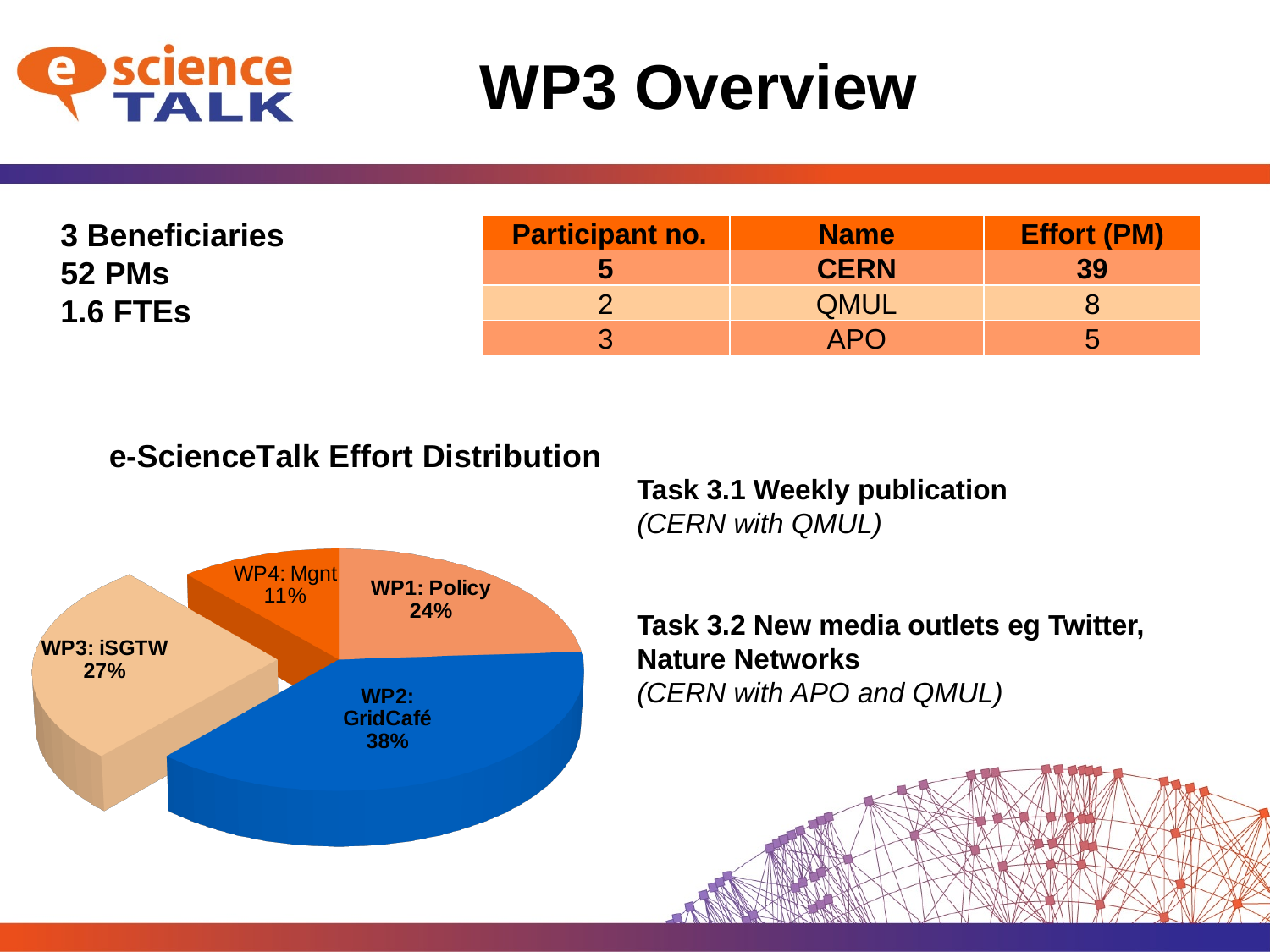
What kind of chart is shown on the slide? Pie chart What is the difference in percentage points between WP2: GridCafé and WP4: Mgnt? 27 What is the title of the chart? e-ScienceTalk Effort Distribution What share of the pie does WP4: Mgnt have? 11% What share of the pie does WP1: Policy have? 24% Which is larger, the share for WP1: Policy or the share for WP3: iSGTW? WP3: iSGTW Which slice of the pie is the smallest? WP4: Mgnt What share of the pie does WP2: GridCafé have? 38% Which slice of the pie is the largest? WP2: GridCafé How many slices does the pie chart have? 4 What is the difference in percentage points between WP3: iSGTW and WP1: Policy? 3